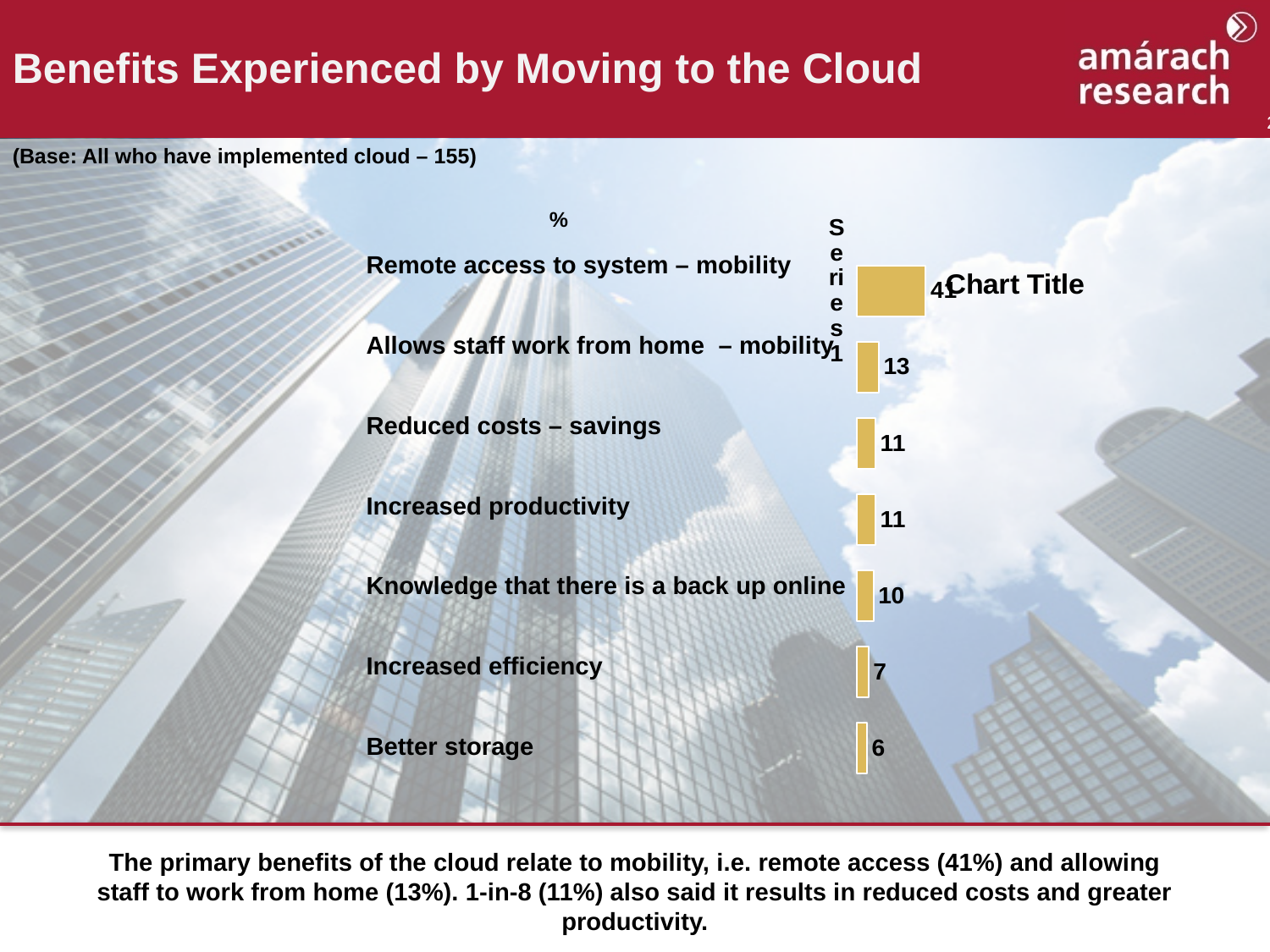
How many benefit categories are shown in the chart? 7 Which is larger, the value for 'Increased productivity' or the value for 'Increased efficiency'? Increased productivity What is the value for 'Better storage'? 6 What is the difference between the values for 'Allows staff work from home – mobility' and 'Better storage'? 7 What kind of chart is shown on the slide? Bar chart What placeholder title text appears on the chart? Chart Title Which benefit has the highest value? Remote access to system – mobility What is the value for 'Reduced costs – savings'? 11 What is the value for 'Allows staff work from home – mobility'? 13 Which benefit has the lowest value? Better storage What is the value for 'Increased efficiency'? 7 What is the value for 'Knowledge that there is a back up online'? 10